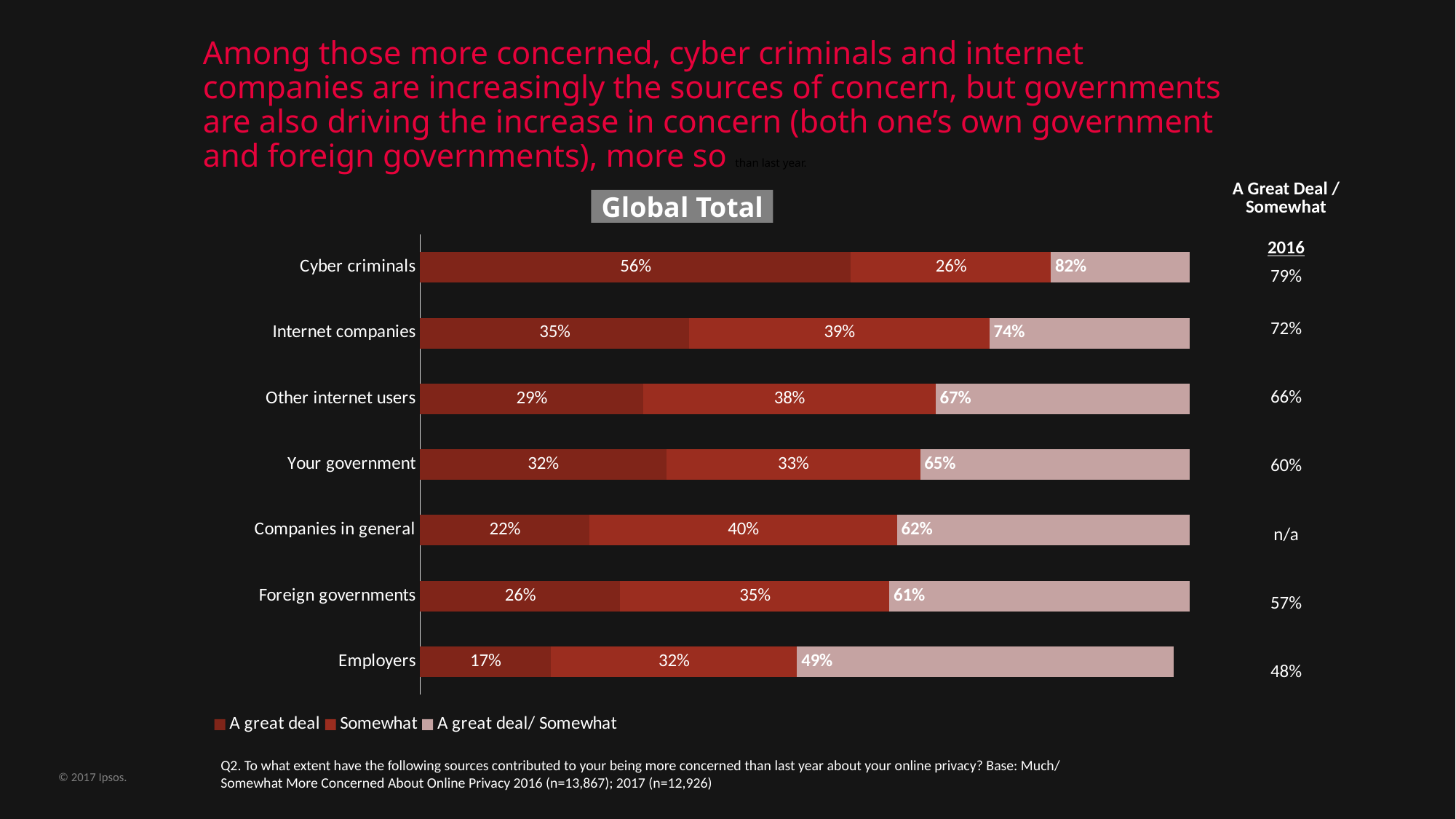
How many series does the legend list? 3 Which category has the lowest 'A great deal/ Somewhat' value? Employers What is the title of the chart? Global Total How many categories are shown in the chart? 7 What kind of chart is shown on the slide? Stacked bar chart What is the 'A great deal/ Somewhat' value for Employers? 49% Which category has the highest 'A great deal' value? Cyber criminals What is the 'A great deal' value for Your government? 32% What is the difference between the 'A great deal' values for Cyber criminals and Internet companies? 21% Which is larger, the 'Somewhat' value for Companies in general or for Foreign governments? Companies in general What is the 'Somewhat' value for Internet companies? 39% What is the 'A great deal' value for Cyber criminals? 56%